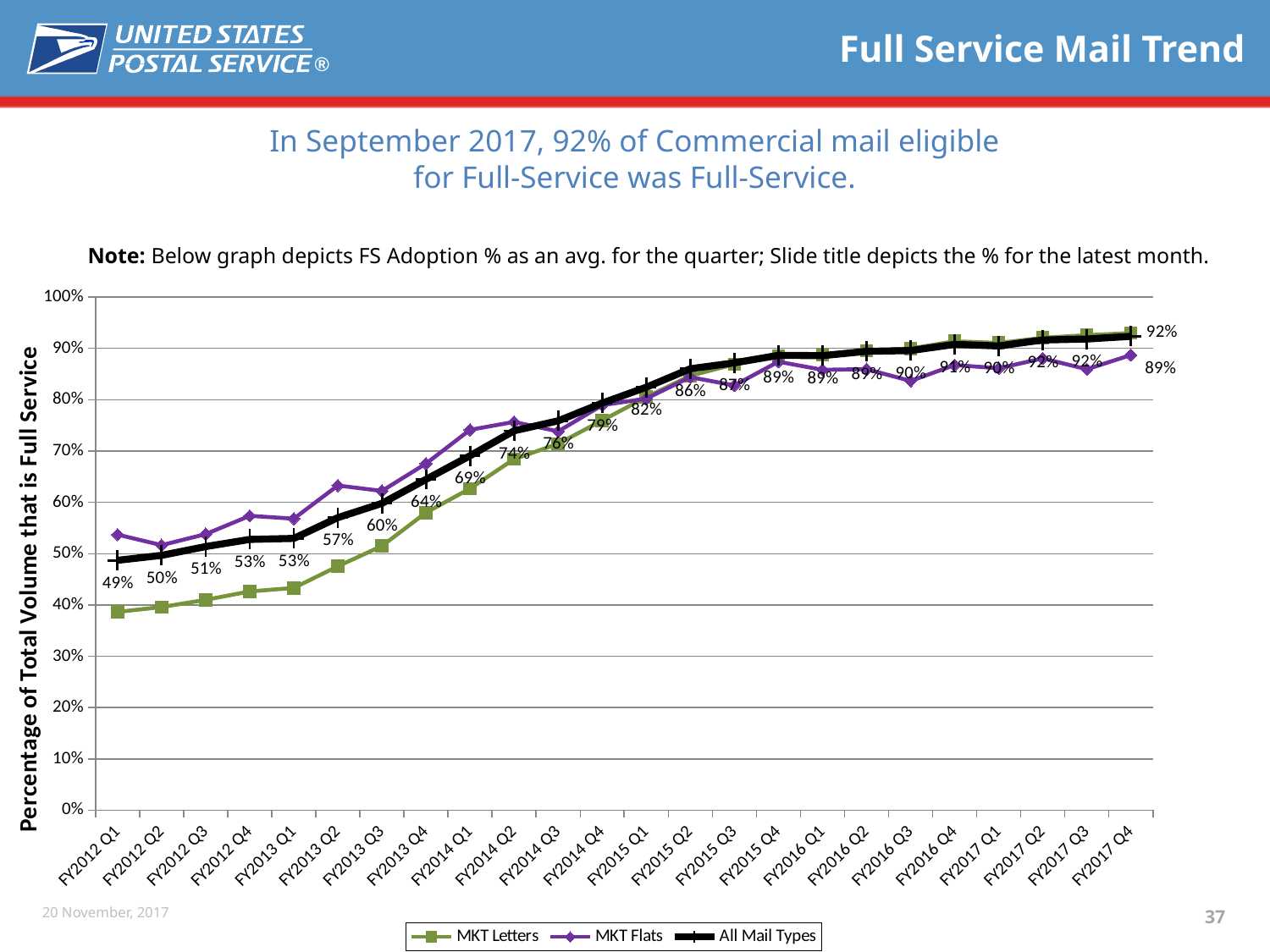
In which quarter is the All Mail Types value lowest? FY2012 Q1 What is the All Mail Types value for FY2015 Q2? 86% What is the title of the y axis? Percentage of Total Volume that is Full Service What is the All Mail Types value for FY2012 Q1? 49% How many quarters are plotted along the x axis? 24 Does the All Mail Types line generally rise or fall from FY2012 Q1 to FY2017 Q4? Rise By how many percentage points did the All Mail Types value rise from FY2012 Q1 to FY2017 Q4? 43 percentage points Is the MKT Flats value for FY2012 Q1 greater or less than 50%? greater In FY2012 Q1, which series is higher: MKT Flats or MKT Letters? MKT Flats What is the All Mail Types value for FY2014 Q2? 74% What kind of chart is shown on the slide? Line chart How many series does the legend list? 3